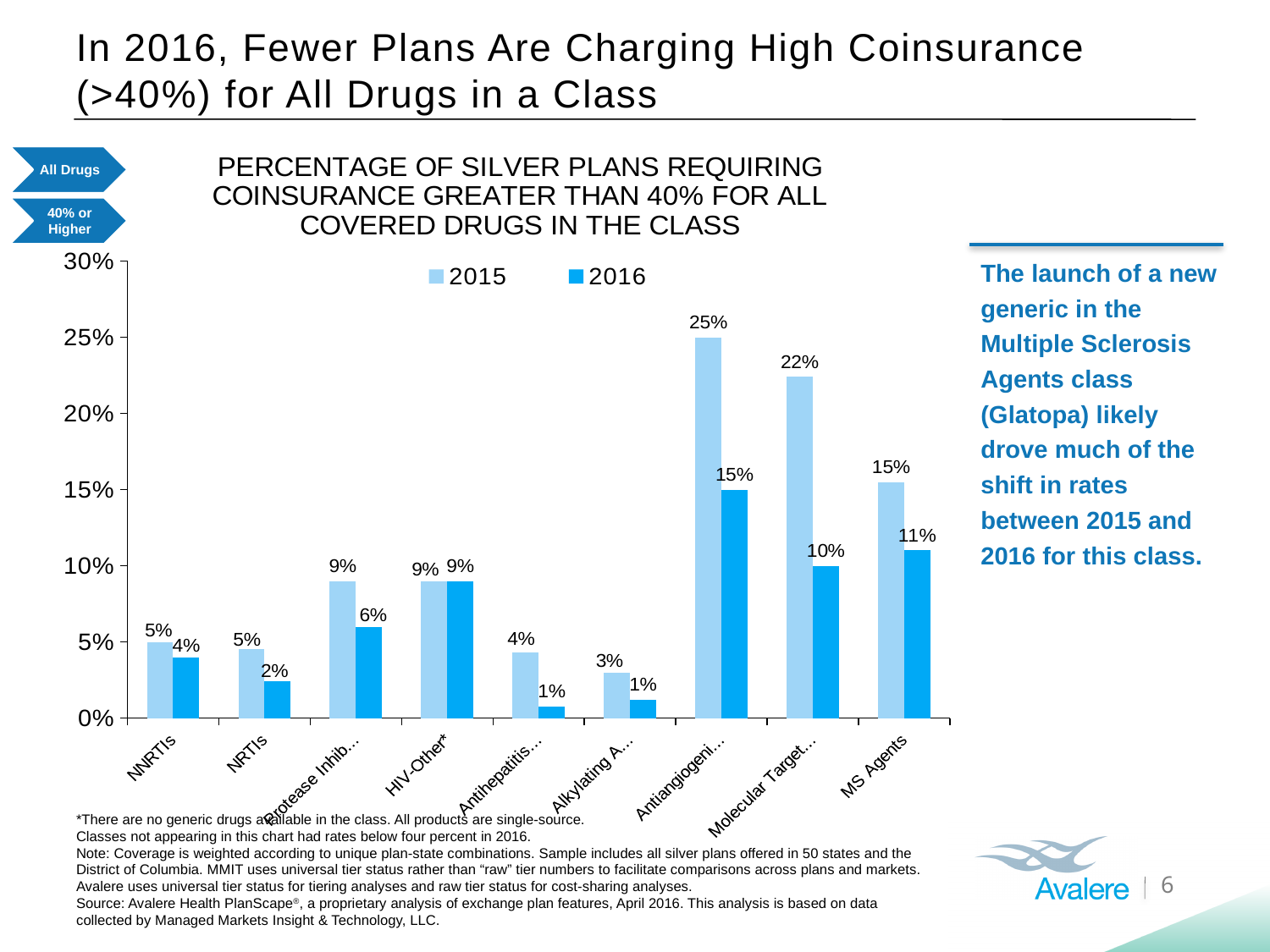
What is the 2016 value for HIV-Other*? 9% How many drug classes are shown on the x axis? 9 How many series does the legend list? 2 What kind of chart is shown on the slide? Bar chart What is the 2015 value for NRTIs? 5% What is the highest 2015 value shown on the chart? 25% What is the 2016 value for NNRTIs? 4% Which category has the lowest 2016 value among NNRTIs, NRTIs, HIV-Other* and MS Agents? NRTIs What is the difference between the 2015 and 2016 values for MS Agents? 4% What is the 2016 value for MS Agents? 11% What is the difference between the 2015 and 2016 values for NRTIs? 3% Which is larger for MS Agents, the 2015 value or the 2016 value? 2015